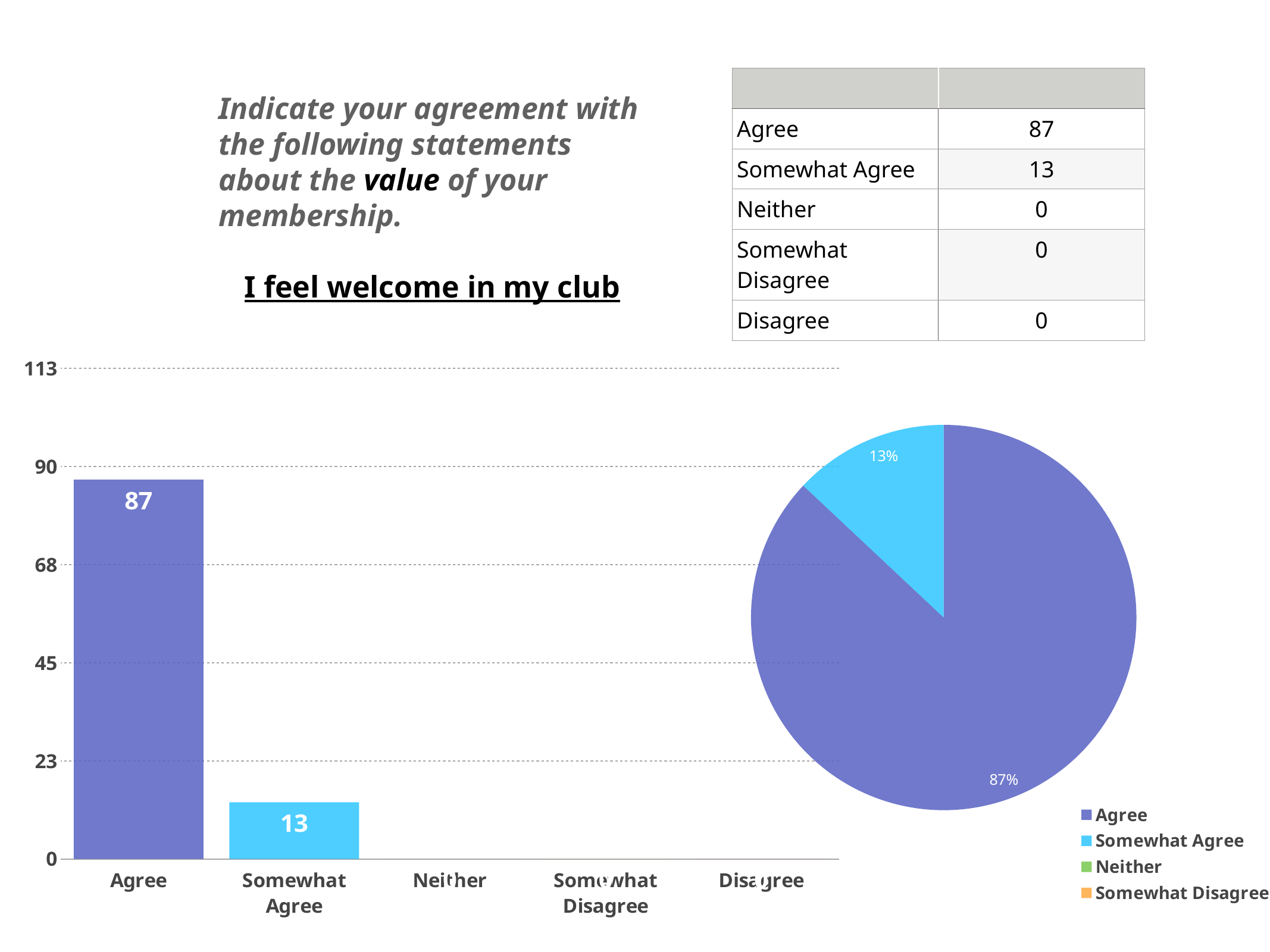
In the bar chart on the left, which is larger, the value for Agree or the value for Somewhat Agree? Agree What kind of chart is the chart on the left of the slide? bar chart What kind of chart is the chart on the right of the slide? pie chart How many categories are shown on the x axis of the bar chart on the left? 5 In the bar chart on the left, which category has the highest value? Agree In the bar chart on the left, is the value for Somewhat Agree greater or less than 23? less In the pie chart on the right, what share of the pie is labelled for Agree? 87% In the bar chart on the left, what is the value for Somewhat Agree? 13 In the pie chart on the right, what share of the pie is labelled for Somewhat Agree? 13% In the bar chart on the left, what is the difference between the values for Agree and Somewhat Agree? 74 In the bar chart on the left, is the value for Agree greater or less than 68? greater In the bar chart on the left, what is the value for Agree? 87